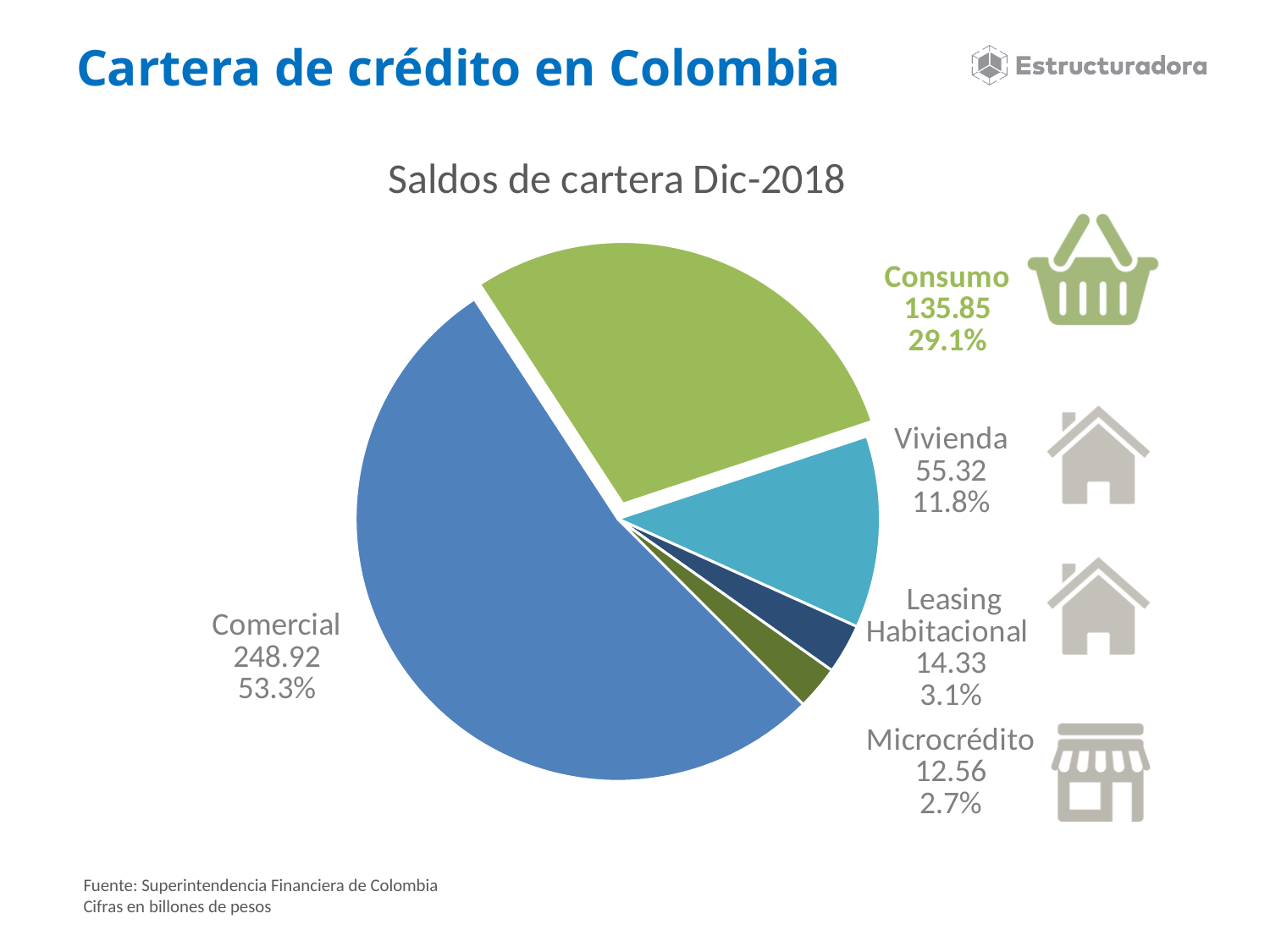
What share of the pie does Microcrédito represent? 2.7% Which category has the largest slice? Comercial What is the value for Comercial? 248.92 What share of the pie does Consumo represent? 29.1% How many slices does the pie chart have? 5 Which category has the smallest slice? Microcrédito What is the value for Consumo? 135.85 What is the title of the chart? Saldos de cartera Dic-2018 What is the difference between the values for Comercial and Consumo? 113.07 What is the value for Leasing Habitacional? 14.33 What kind of chart is shown on the slide? pie chart What is the value for Vivienda? 55.32